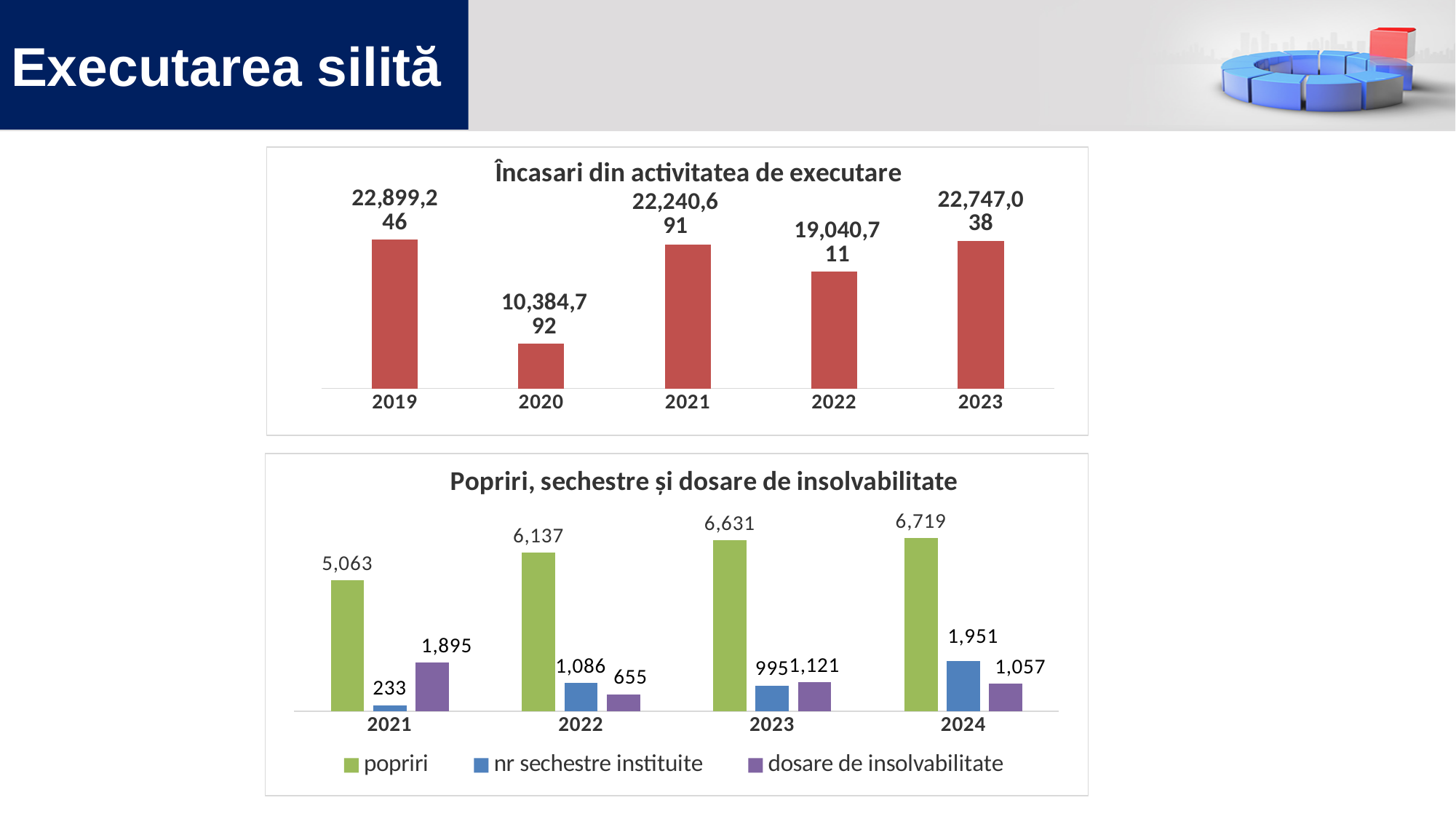
In the chart 'Încasari din activitatea de executare', what is the difference between the values for 2023 and 2022? 3,706,327 In the chart 'Încasari din activitatea de executare', what is the value for 2020? 10,384,792 In the chart 'Popriri, sechestre și dosare de insolvabilitate', which is larger in 2022: nr sechestre instituite or dosare de insolvabilitate? nr sechestre instituite In the chart 'Popriri, sechestre și dosare de insolvabilitate', what is the value of popriri for 2023? 6,631 In the chart 'Popriri, sechestre și dosare de insolvabilitate', in which year is dosare de insolvabilitate highest? 2021 In the chart 'Încasari din activitatea de executare', which year has the highest value? 2019 In the chart 'Popriri, sechestre și dosare de insolvabilitate', does the popriri series rise or fall from 2021 to 2024? rise In the chart 'Popriri, sechestre și dosare de insolvabilitate', what is the value of nr sechestre instituite for 2021? 233 In the chart 'Încasari din activitatea de executare', which year has the lowest value? 2020 In the chart 'Încasari din activitatea de executare', how many years are shown? 5 What kind of chart is 'Popriri, sechestre și dosare de insolvabilitate'? bar chart In the chart 'Popriri, sechestre și dosare de insolvabilitate', how many series does the legend list? 3